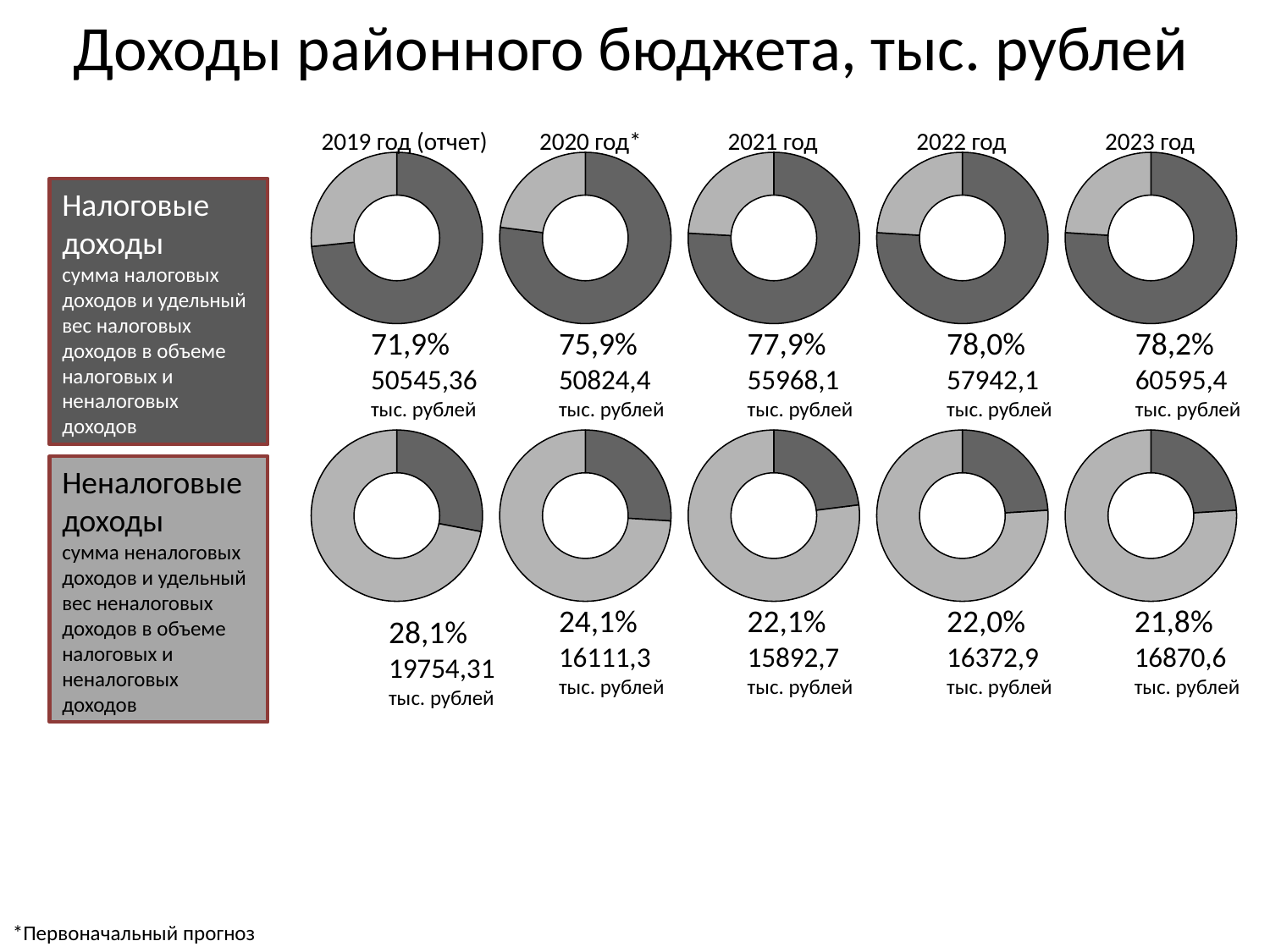
What kind of chart is used on the slide? Doughnut (pie) chart In which year is the amount of non-tax revenues (Неналоговые доходы) the lowest? 2021 год What share of revenues do non-tax revenues (Неналоговые доходы) make up in the 2021 год chart? 22,1% What share of revenues do tax revenues (Налоговые доходы) make up in the 2019 год (отчет) chart? 71,9% How does the share of non-tax revenues (Неналоговые доходы) change from 2019 to 2023? It falls What is the amount of non-tax revenues (Неналоговые доходы) shown for 2019 год (отчет)? 19754,31 тыс. рублей Which is larger: the tax revenue amount for 2022 год or for 2021 год? 2022 год In which year is the share of tax revenues (Налоговые доходы) the highest? 2023 год What is the title of the slide? Доходы районного бюджета, тыс. рублей How many years are shown across the charts on the slide? 5 What is the amount of tax revenues (Налоговые доходы) shown for 2023 год? 60595,4 тыс. рублей What is the difference between the tax revenue amounts for 2023 год and 2022 год? 2653,3 тыс. рублей